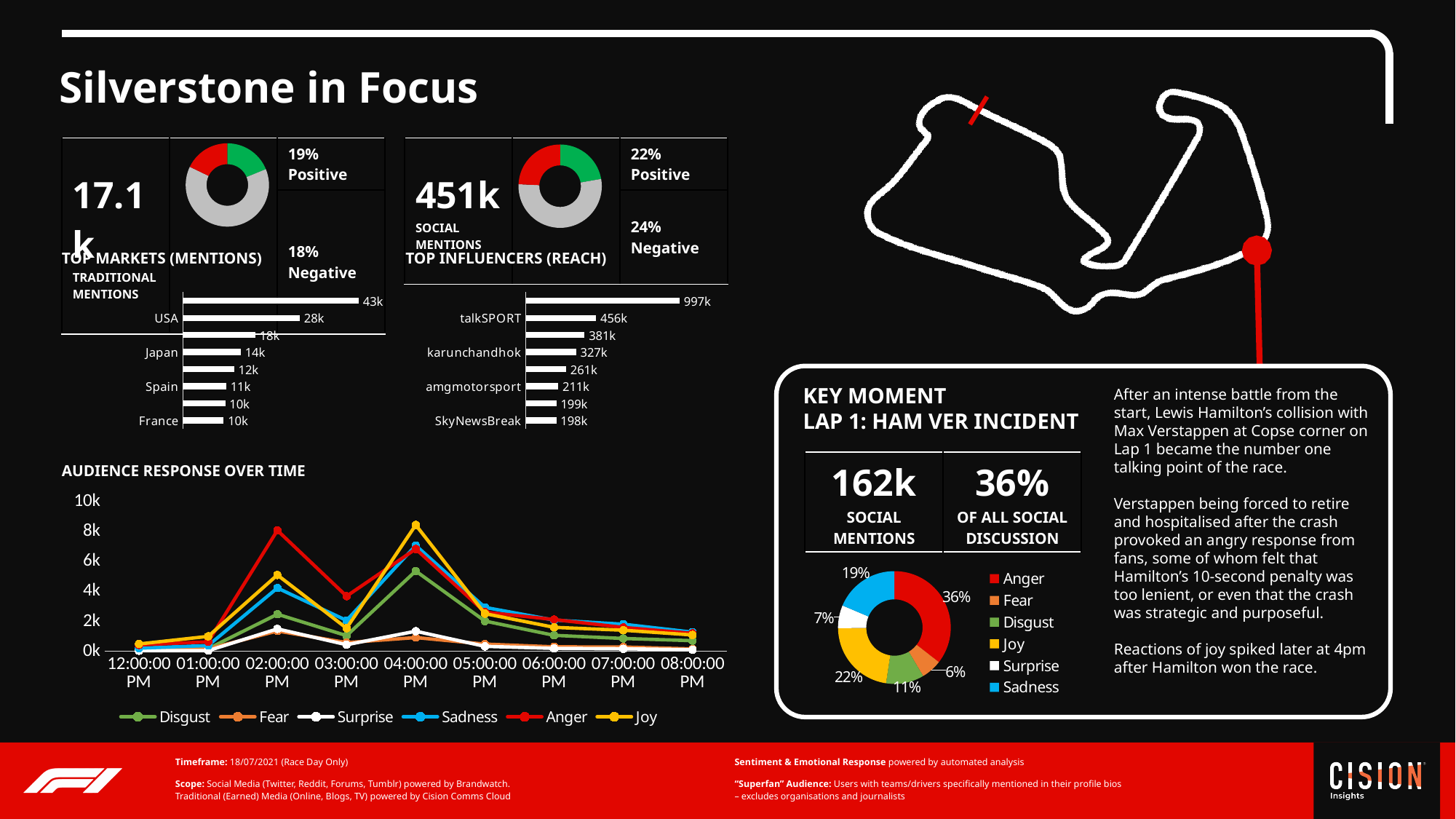
In the Key Moment donut chart, what is the difference between the Joy and Sadness shares? 3% What kind of chart is the Audience Response Over Time chart? line chart In the Top Markets (Mentions) chart, what is the value for USA? 28k In the Audience Response Over Time chart, which is larger at 02:00:00 PM, Anger or Disgust? Anger In the Top Influencers (Reach) chart, what is the difference between talkSPORT and karunchandhok? 129k How many series does the legend of the Audience Response Over Time chart list? 6 In the Top Influencers (Reach) chart, what is the value for SkyNewsBreak? 198k In the Key Moment donut chart, which emotion has the smallest share? Fear In the Audience Response Over Time chart, is the value for Anger at 02:00:00 PM greater or less than 6k? greater In the Key Moment donut chart, what share does Anger have? 36% In the Top Influencers (Reach) chart, what is the value for talkSPORT? 456k In the Top Markets (Mentions) chart, what is the value for Japan? 14k